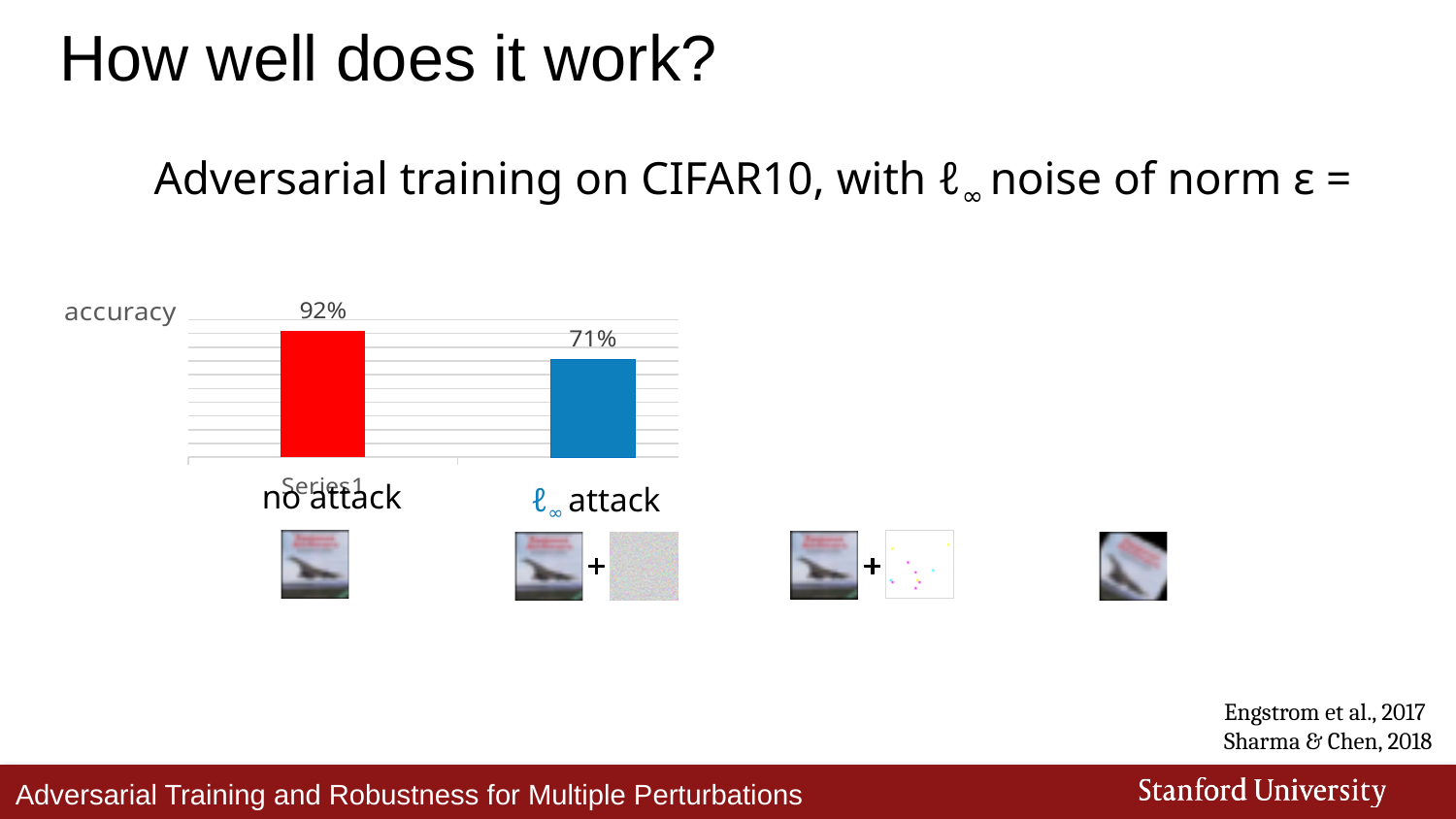
What colour is the "no attack" bar? red What kind of chart is shown on the slide? bar chart What quantity does the chart's vertical axis label say is plotted? accuracy What is the accuracy shown for the "ℓ∞ attack" bar? 71% Which bar has the lowest accuracy? ℓ∞ attack What is the difference in accuracy between the "no attack" bar and the "ℓ∞ attack" bar? 21% What is the accuracy shown for the "no attack" bar? 92% How many bars are plotted in the chart? 2 Which bar has the highest accuracy? no attack Which is larger, the accuracy under no attack or under the ℓ∞ attack? no attack Do the values fall or rise from the left bar to the right bar? fall